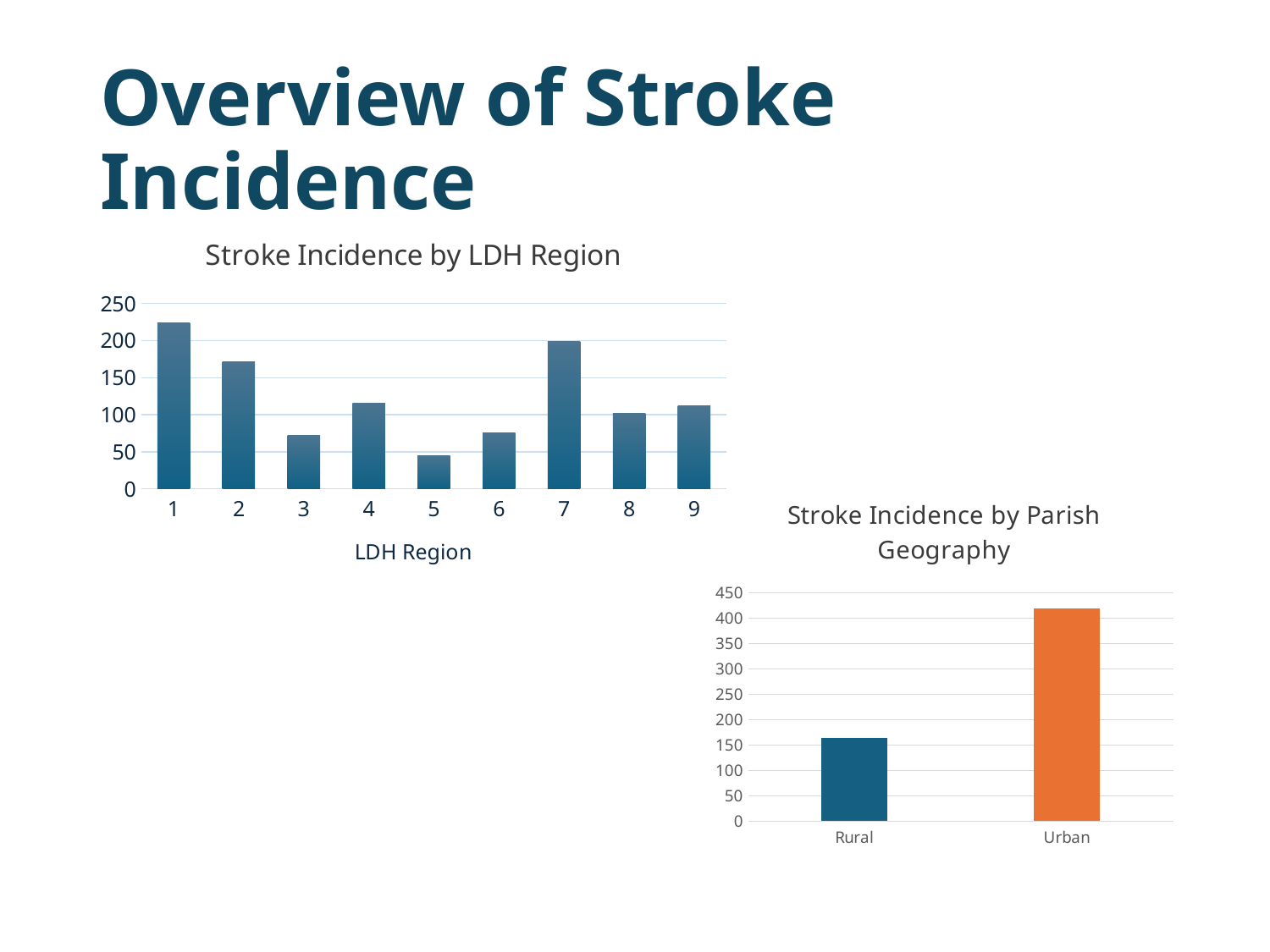
In the 'Stroke Incidence by LDH Region' chart, what is the label on the x axis? LDH Region In the 'Stroke Incidence by LDH Region' chart, which LDH region has the lowest stroke incidence? 5 In the 'Stroke Incidence by LDH Region' chart, how many LDH regions are plotted? 9 In the 'Stroke Incidence by LDH Region' chart, what kind of chart is shown? bar chart In the 'Stroke Incidence by Parish Geography' chart, is the value for Urban greater or less than 400? greater In the 'Stroke Incidence by LDH Region' chart, which LDH region has the highest stroke incidence? 1 In the 'Stroke Incidence by LDH Region' chart, is the value for region 3 greater or less than 100? less In the 'Stroke Incidence by Parish Geography' chart, which category has the higher stroke incidence, Rural or Urban? Urban In the 'Stroke Incidence by Parish Geography' chart, how many categories are plotted? 2 In the 'Stroke Incidence by LDH Region' chart, is the value for region 7 greater or less than 150? greater In the 'Stroke Incidence by LDH Region' chart, which has the higher stroke incidence, region 2 or region 4? region 2